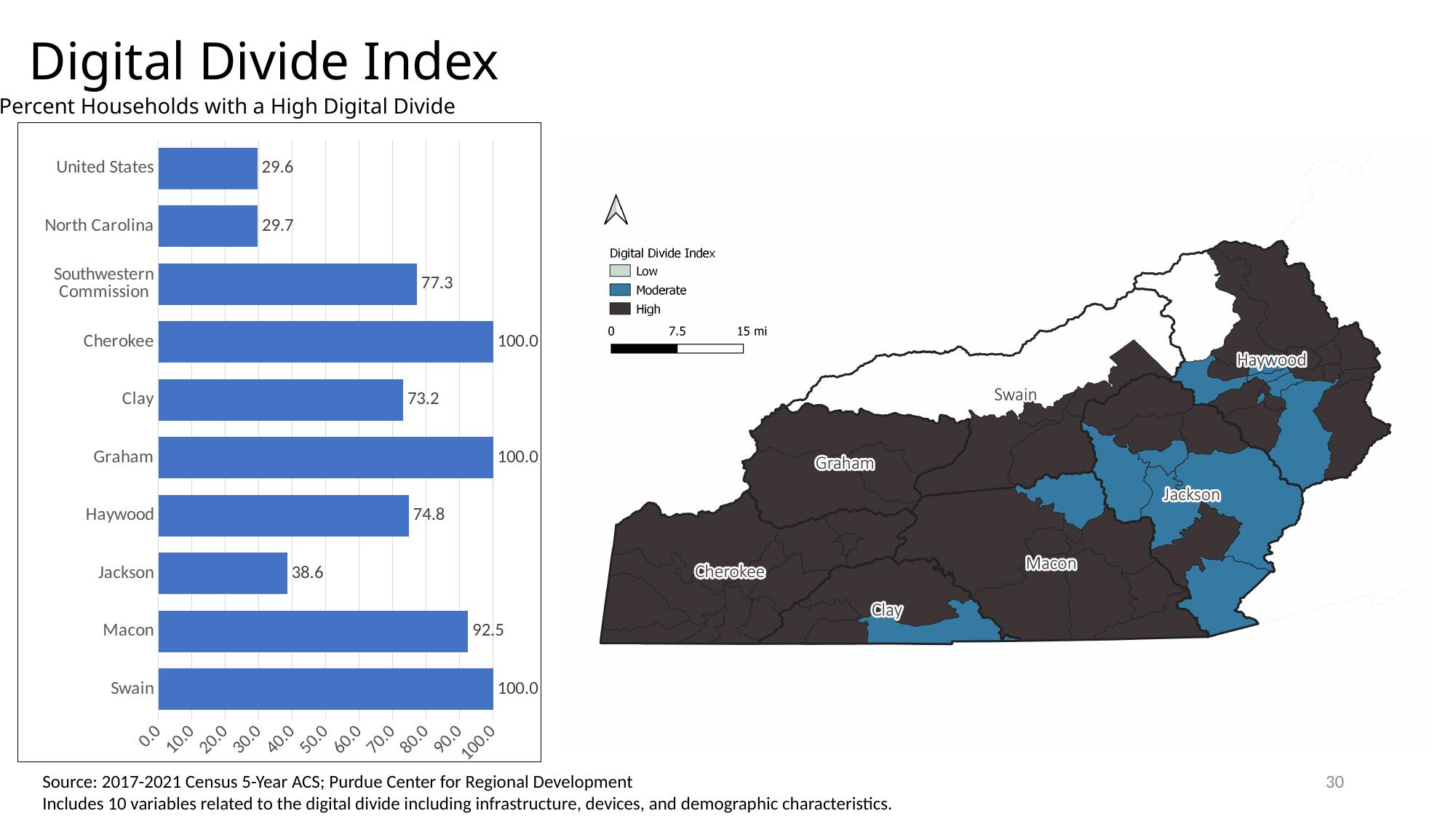
What is the value for Macon in the bar chart? 92.5 What is the value for Jackson in the bar chart? 38.6 How many categories are shown in the bar chart? 10 What is the difference between the values for Macon and Clay in the bar chart? 19.3 What is the value for the Southwestern Commission in the bar chart? 77.3 How many categories in the bar chart have a value of 100.0? 3 Which is larger in the bar chart, Haywood or Clay? Haywood Is the value for Jackson in the bar chart greater or less than 50.0? less What is the value for Cherokee in the bar chart? 100.0 What is the title of the bar chart? Percent Households with a High Digital Divide What kind of chart is shown on the left of the slide? bar chart Which category has the lowest value in the bar chart? United States